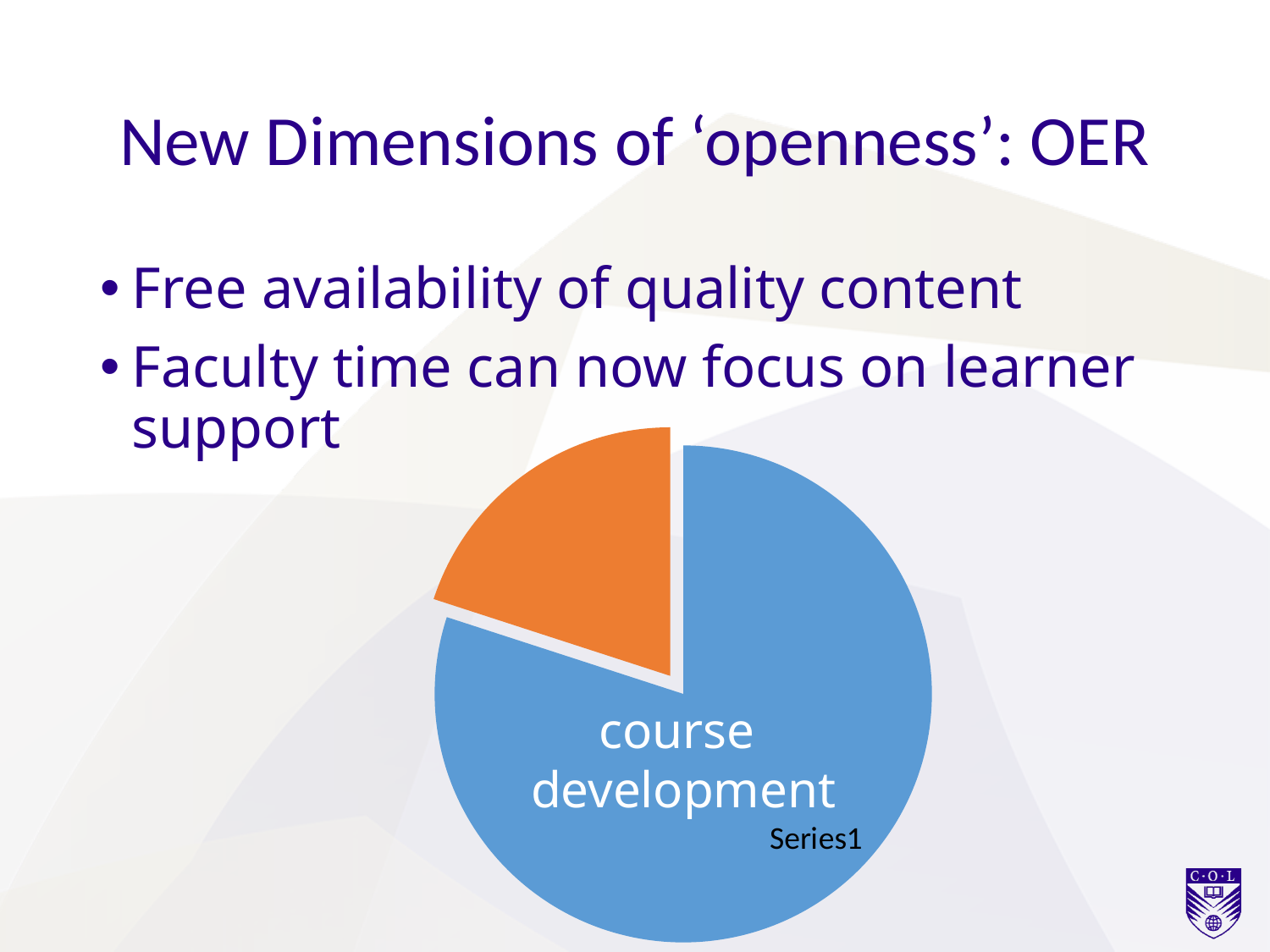
Is the blue slice or the orange slice of the pie chart larger? blue What kind of chart is shown on the slide? pie chart Is the 'course development' slice larger or smaller than the orange slice? larger How many slices does the pie chart have? 2 What series name is printed on the pie chart? Series1 Which slice of the pie chart is the largest? course development What colour is the 'course development' slice of the pie chart? blue